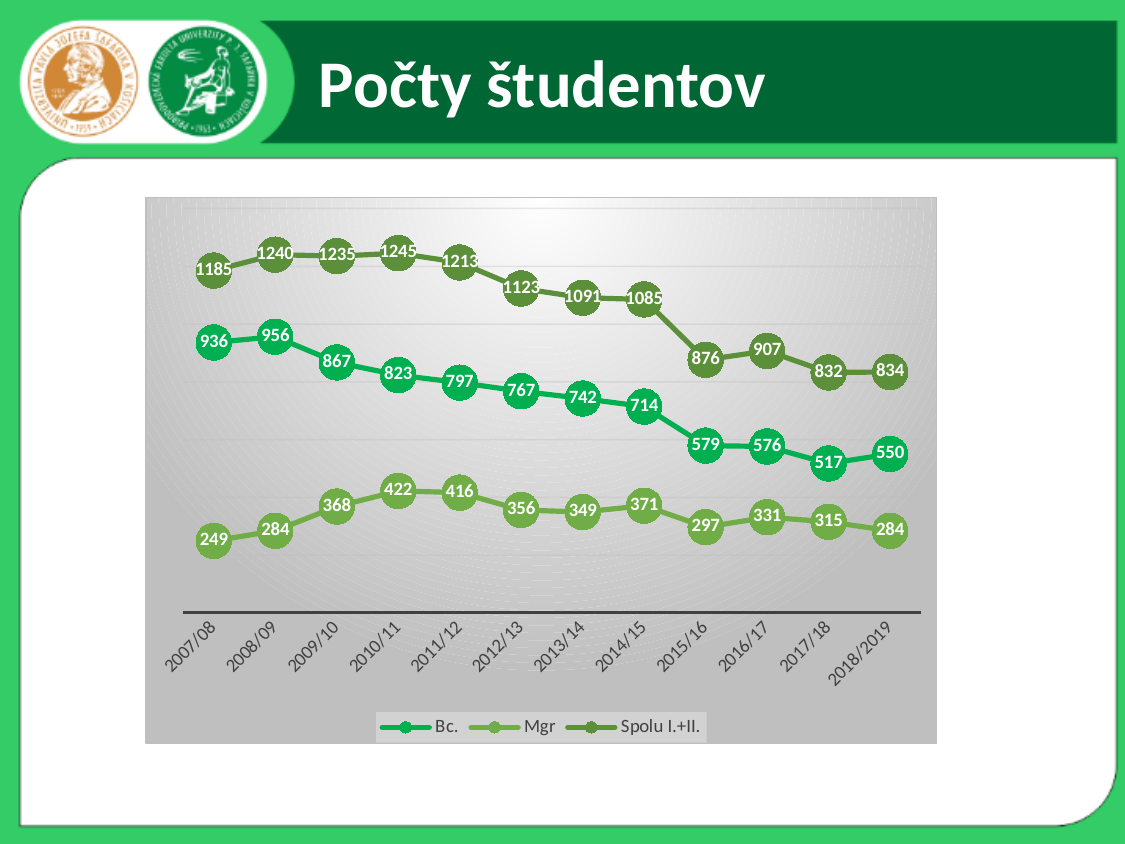
What is the difference between the Spolu I.+II. values for 2014/15 and 2015/16? 209 How many years are shown on the x axis? 12 Does the Bc. series generally rise or fall from 2008/09 to 2017/18? fall Which is larger, the Mgr value for 2011/12 or the Mgr value for 2012/13? 2011/12 In which year does the Mgr series have its lowest value? 2007/08 What is the value of the Spolu I.+II. series for 2018/2019? 834 What kind of chart is shown on the slide? line chart How many series does the legend list? 3 What is the value of the Bc. series for 2007/08? 936 In which year does the Spolu I.+II. series reach its highest value? 2010/11 What is the difference between the Bc. values for 2008/09 and 2009/10? 89 What is the value of the Mgr series for 2010/11? 422